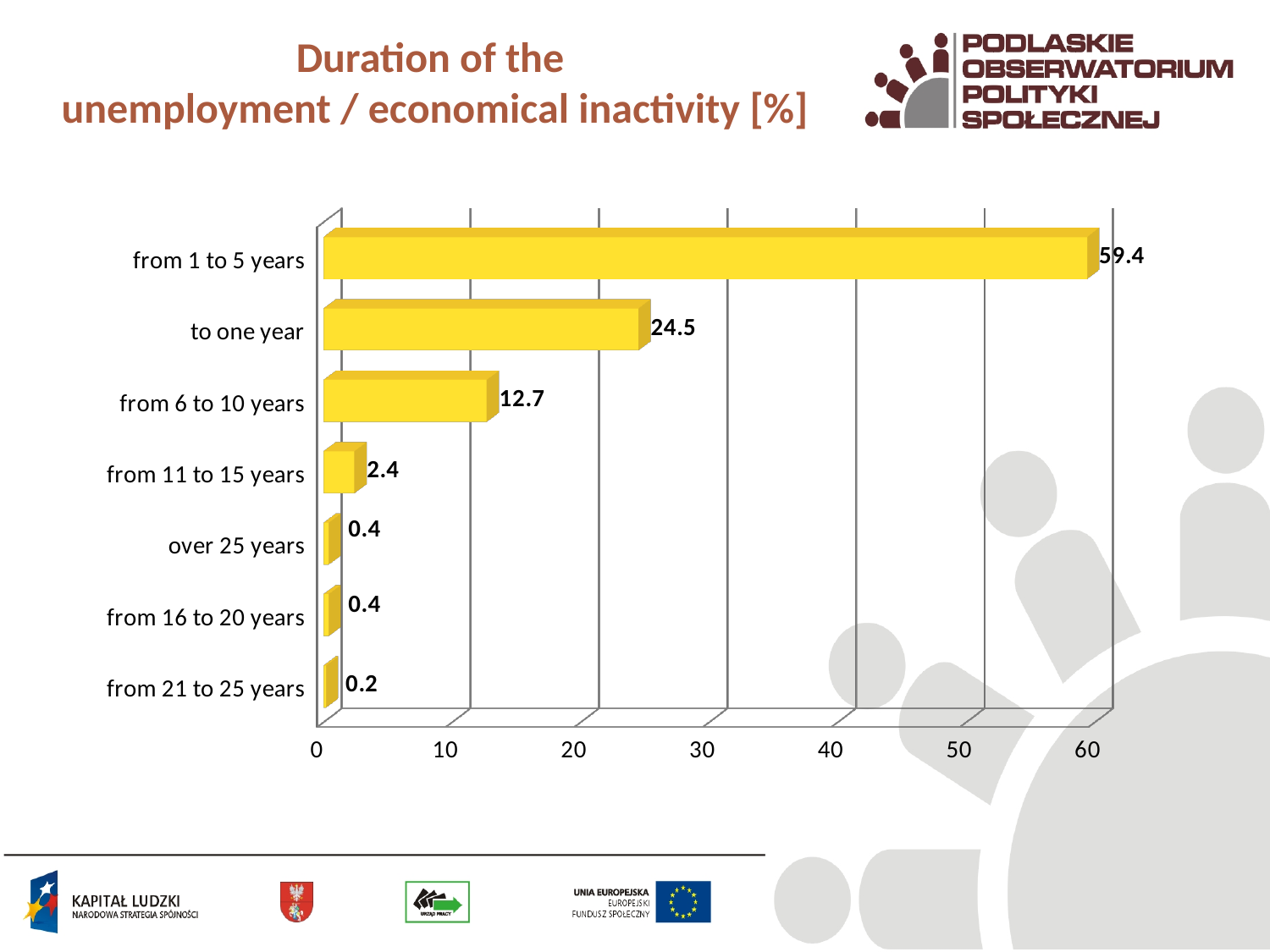
What is the difference between the values for 'from 1 to 5 years' and 'to one year'? 34.9 Which is larger, the value for 'from 6 to 10 years' or 'from 11 to 15 years'? from 6 to 10 years Is the value for 'to one year' greater or less than 20? greater What is the value for 'to one year'? 24.5 How many categories are shown in the chart? 7 Which category has the highest value? from 1 to 5 years What kind of chart is shown on the slide? bar chart What is the value for 'from 1 to 5 years'? 59.4 What is the value for 'from 11 to 15 years'? 2.4 What is the title of the slide? Duration of the unemployment / economical inactivity [%] What is the value for 'from 6 to 10 years'? 12.7 Which category has the lowest value? from 21 to 25 years